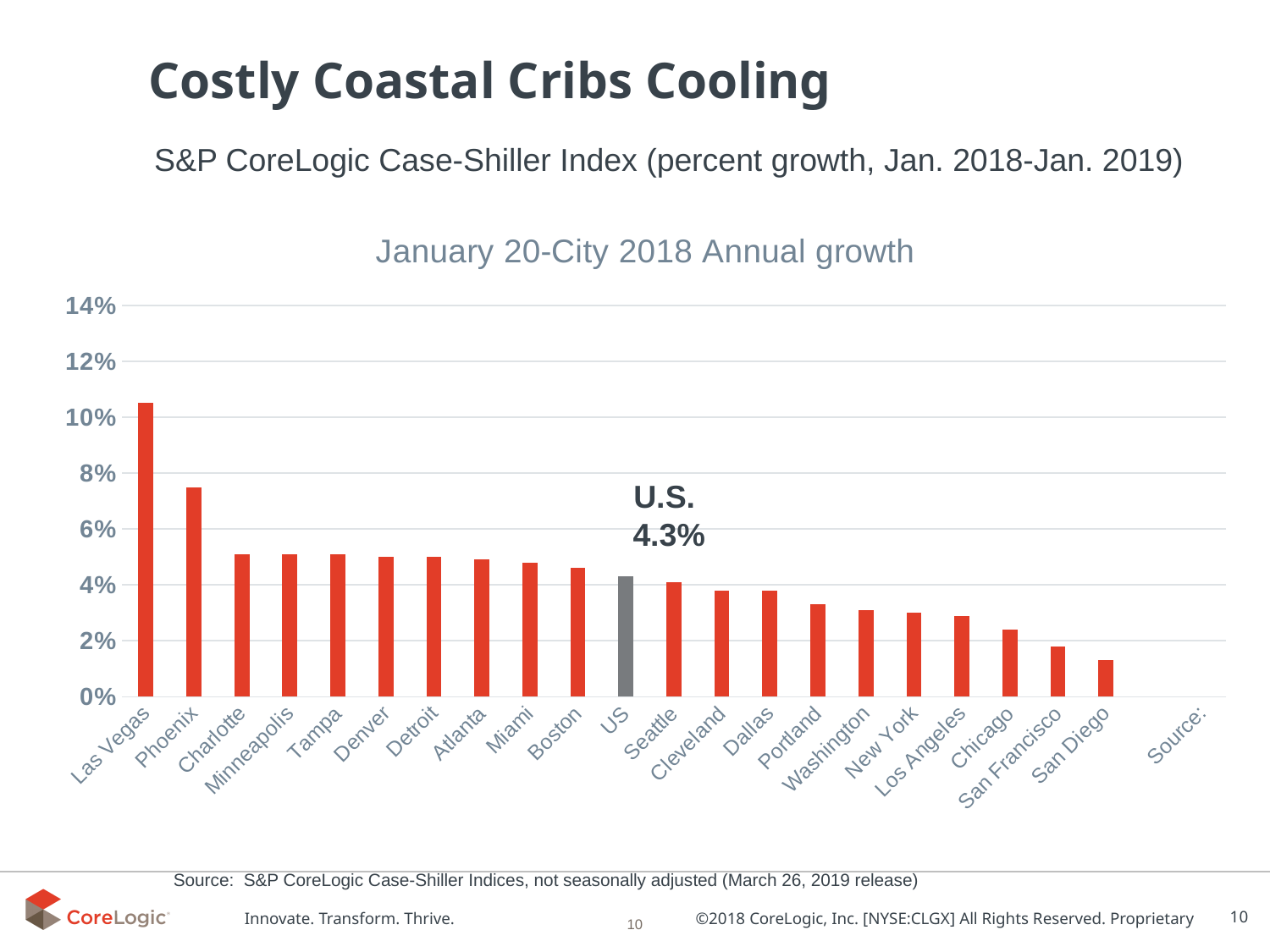
What is the title of the chart? January 20-City 2018 Annual growth Is the value for Las Vegas greater or less than 10%? greater Is the value for Phoenix greater or less than 8%? less Which city has the highest annual growth in the chart? Las Vegas Is the value for San Diego greater or less than 2%? less What kind of chart is shown on the slide? bar chart What is the annual growth value shown for the U.S.? 4.3% Do the bar values rise or fall moving from left to right across the chart? fall Which has the larger annual growth, Phoenix or Seattle? Phoenix Which has the larger annual growth, Chicago or Boston? Boston Which city has the lowest annual growth in the chart? San Diego